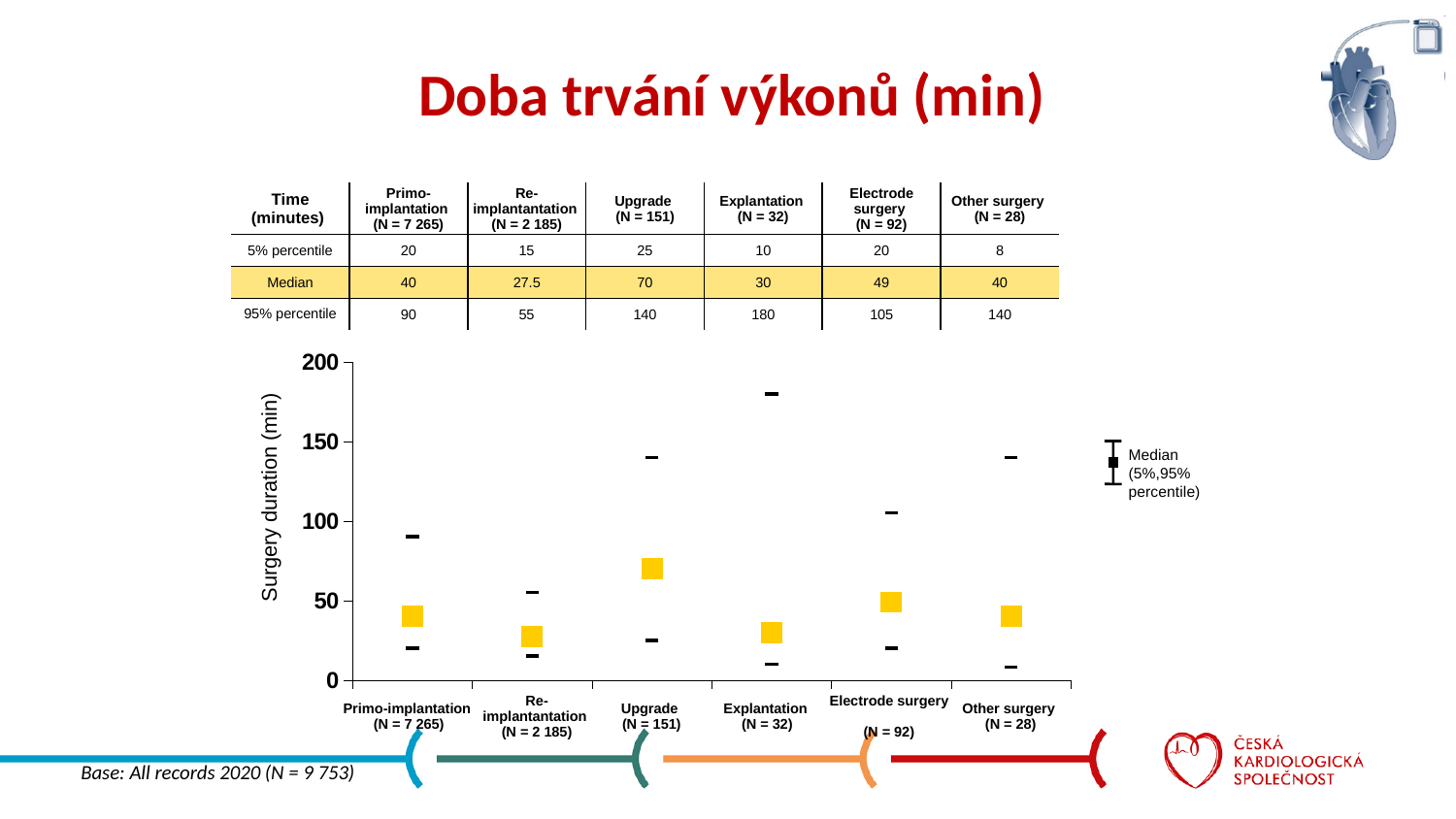
What is the 5% percentile surgery duration for Other surgery? 8 What is the median surgery duration for Upgrade? 70 Which has a higher 95% percentile surgery duration, Explantation or Electrode surgery? Explantation Is the 95% percentile value for Explantation greater or less than 150? greater What is the label of the y axis of the chart? Surgery duration (min) Which procedure category has the lowest median surgery duration? Re-implantantation How many procedure categories are shown on the x axis of the chart? 6 What does the yellow square marker in the chart represent according to the legend? Median Which procedure category has the highest median surgery duration? Upgrade What is the 95% percentile surgery duration for Explantation? 180 What is the median surgery duration for Electrode surgery? 49 What is the difference between the median surgery duration for Upgrade and for Primo-implantation? 30